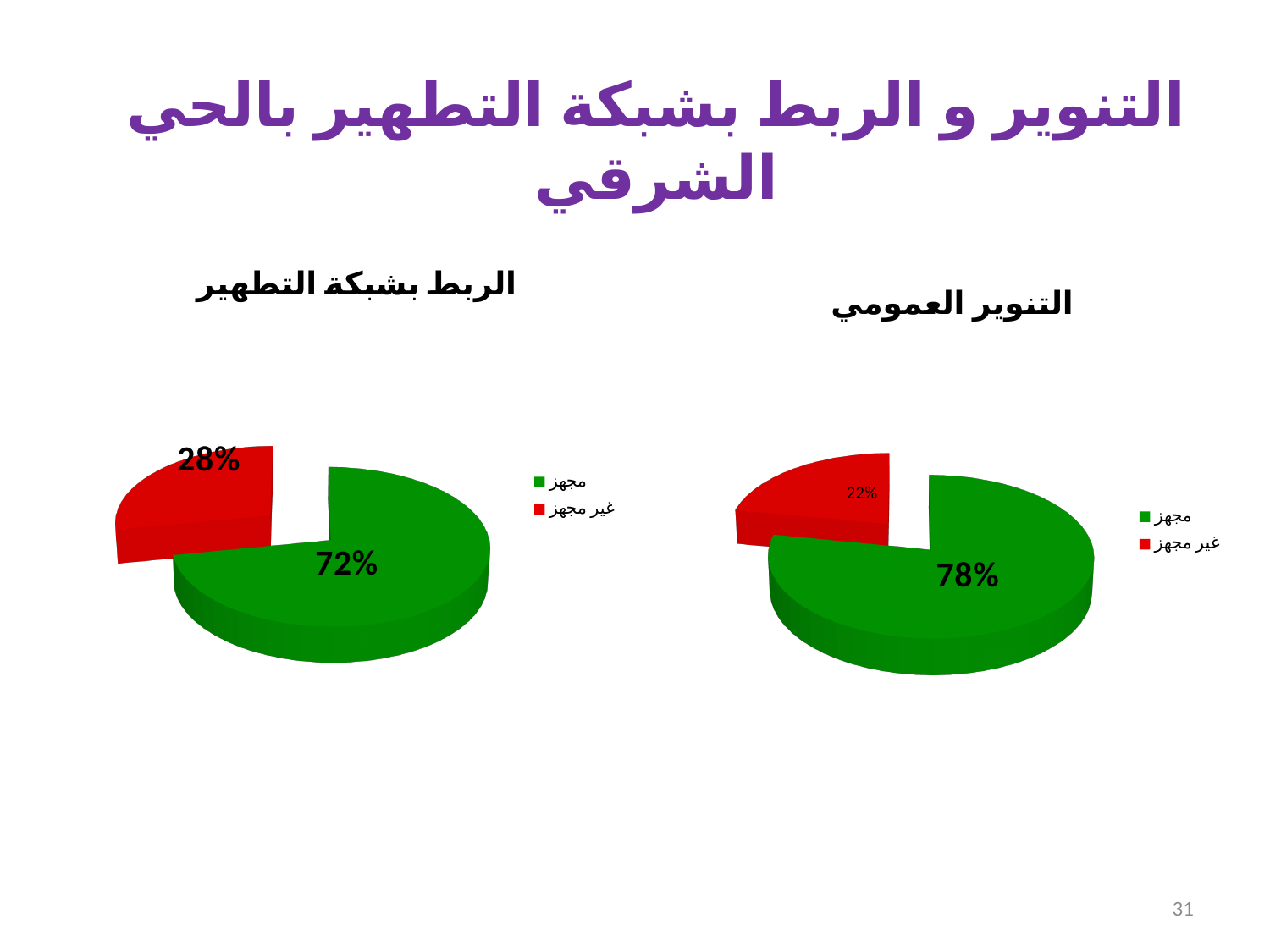
Which chart has the larger value for مجهز, the left chart (الربط بشبكة التطهير) or the right chart (التنوير العمومي)? التنوير العمومي In the left chart (الربط بشبكة التطهير), what is the difference between مجهز and غير مجهز? 44% In the right chart (التنوير العمومي), which category has the largest slice? مجهز In the left chart (الربط بشبكة التطهير), what colour is the slice for غير مجهز? Red In the right chart (التنوير العمومي), what is the difference between مجهز and غير مجهز? 56% In the right chart (التنوير العمومي), what is the value for غير مجهز? 22% In the left chart (الربط بشبكة التطهير), which category has the smallest slice? غير مجهز In the left chart (الربط بشبكة التطهير), what is the value for غير مجهز? 28% In the right chart (التنوير العمومي), what is the value for مجهز? 78% How many slices does the right chart (التنوير العمومي) have? 2 What type of chart is used for the left chart titled الربط بشبكة التطهير? Pie chart In the left chart (الربط بشبكة التطهير), what is the value for مجهز? 72%